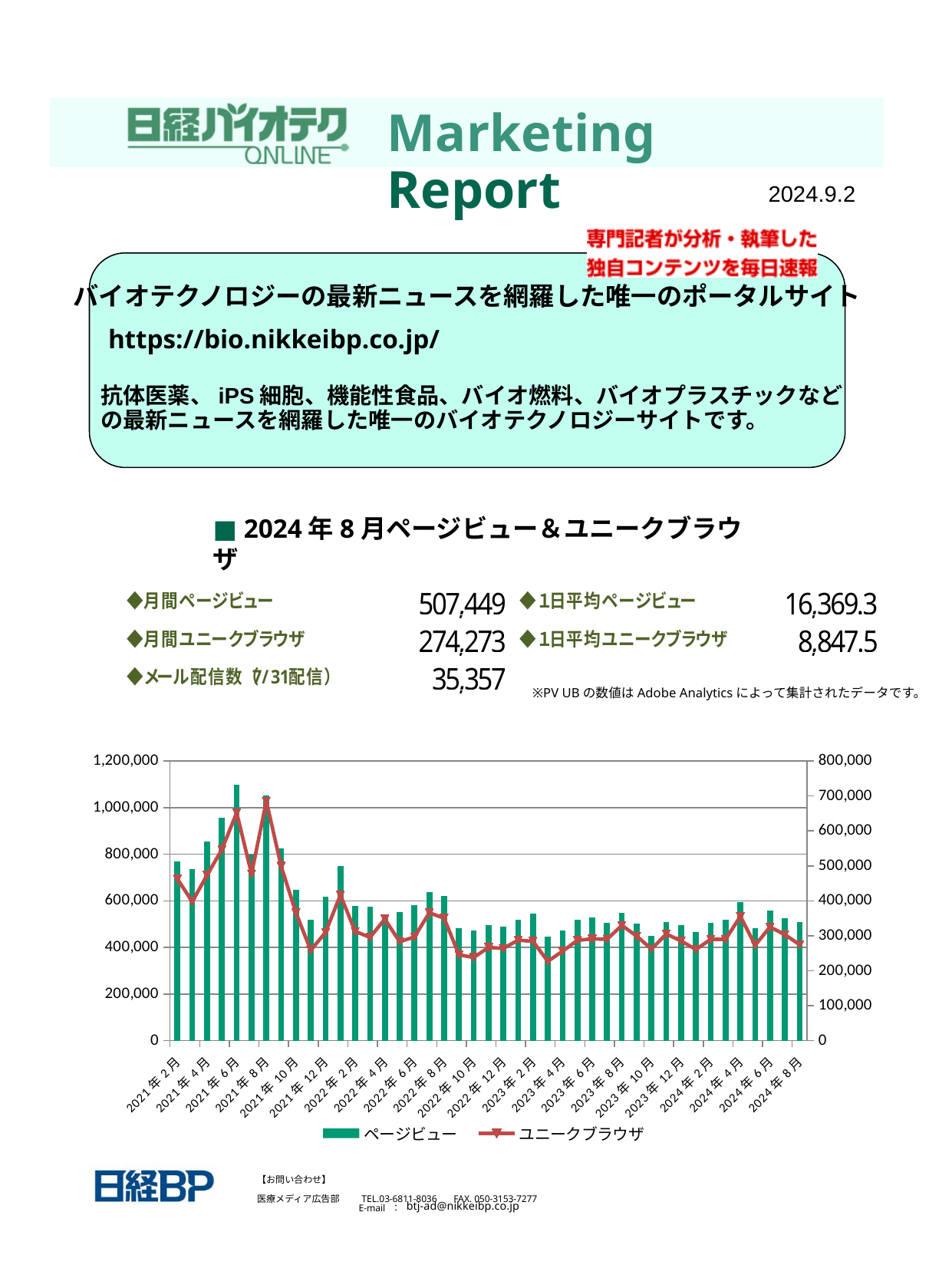
Is the ユニークブラウザ value for 2023年4月 greater or less than 300,000? less What are the two series named in the chart legend? ページビュー and ユニークブラウザ Which month has the highest ユニークブラウザ value in the chart? 2021年8月 Is the ユニークブラウザ value for 2021年2月 greater or less than 400,000? greater Is the ページビュー value for 2021年2月 greater or less than 600,000? greater Which series is drawn as bars in the chart? ページビュー How many series does the chart legend list? 2 Do the ページビュー values generally rise or fall from 2021 to 2024 along the x axis? fall Which has the larger ページビュー value, 2021年2月 or 2024年8月? 2021年2月 What kind of chart is shown on the slide? A combination bar and line chart